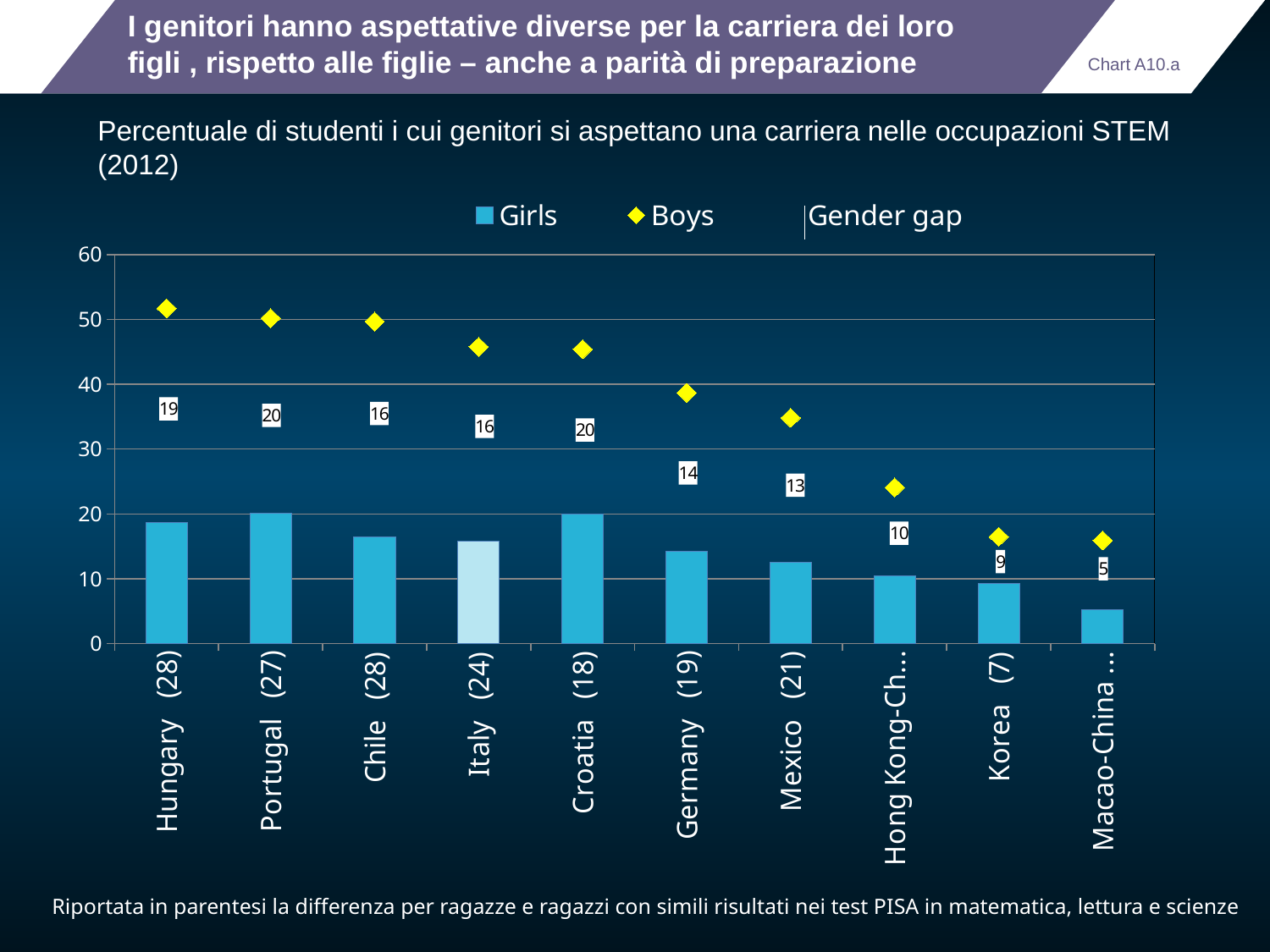
What is the gender gap value shown for Hungary? 19 How many series does the legend list? 3 Which has a higher Girls bar, Portugal or Korea? Portugal Which country has the smallest gender gap label? Macao-China What is the difference between the gender gap labels for Hungary and Germany? 5 How many countries are shown on the x axis? 10 Do the Boys values rise or fall moving from left to right along the x axis? fall Is the Boys value for Germany greater or less than 30? greater What is the gender gap value shown for Mexico? 13 What marker shape and colour represents Boys in the legend? yellow diamond What is the gender gap value shown for Macao-China? 5 Is the Girls value for Macao-China greater or less than 10? less